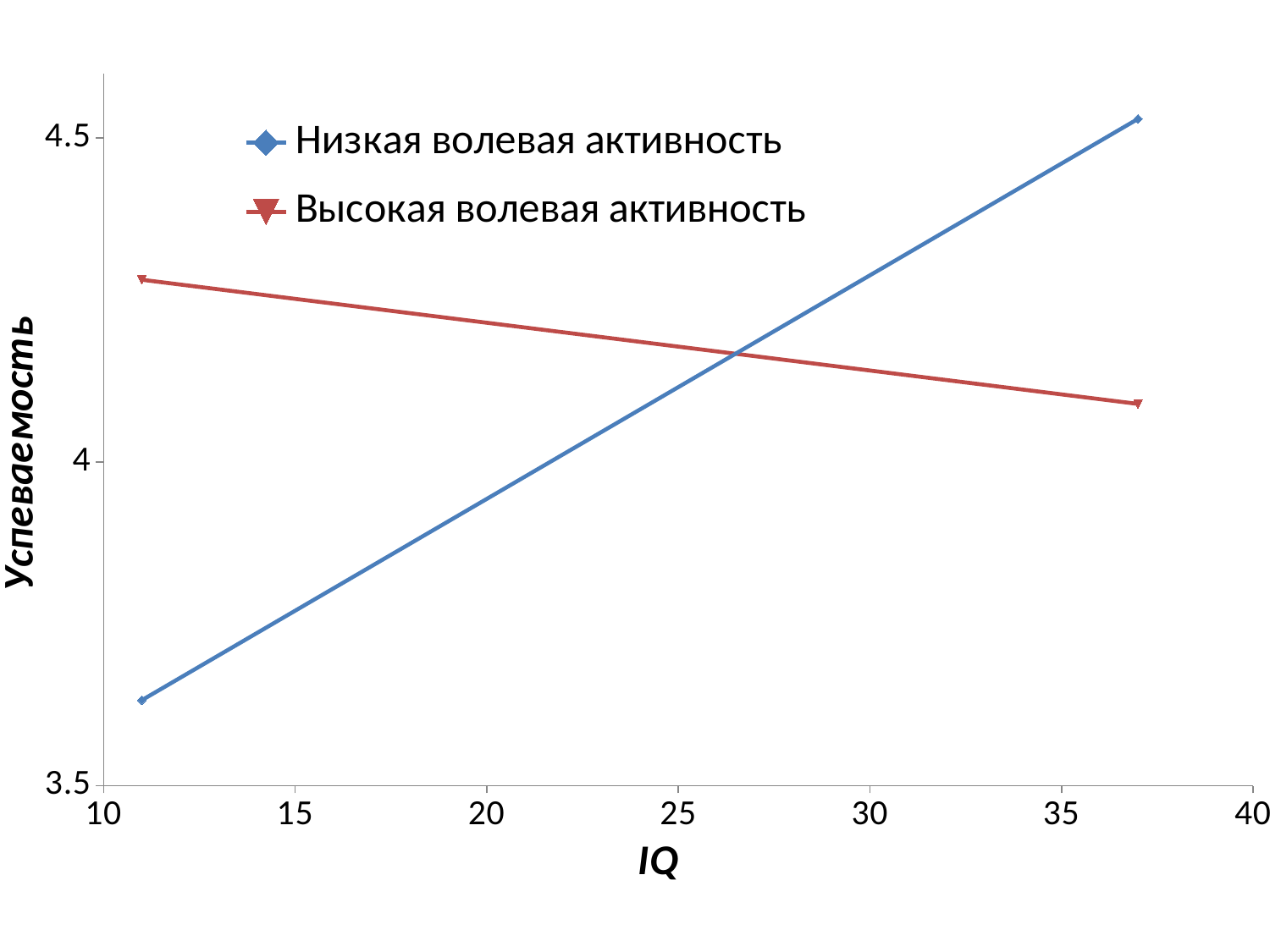
Does the line for Низкая волевая активность rise or fall as IQ increases? rises Does the line for Высокая волевая активность rise or fall as IQ increases? falls How many series does the legend list? 2 Is the value for Низкая волевая активность at the right end of the line greater or less than 4.5? greater What are the two series named in the legend? Низкая волевая активность; Высокая волевая активность At the highest IQ value plotted, which series has the higher Успеваемость: Низкая волевая активность or Высокая волевая активность? Низкая волевая активность At the lowest IQ value plotted, which series has the higher Успеваемость: Низкая волевая активность or Высокая волевая активность? Высокая волевая активность Is the value for Высокая волевая активность at the right end of the line greater or less than 4? greater What kind of chart is shown on the slide? line chart What is the title of the vertical axis? Успеваемость How many data points are plotted for each series? 2 Is the value for Низкая волевая активность at the left end of the line greater or less than 4? less